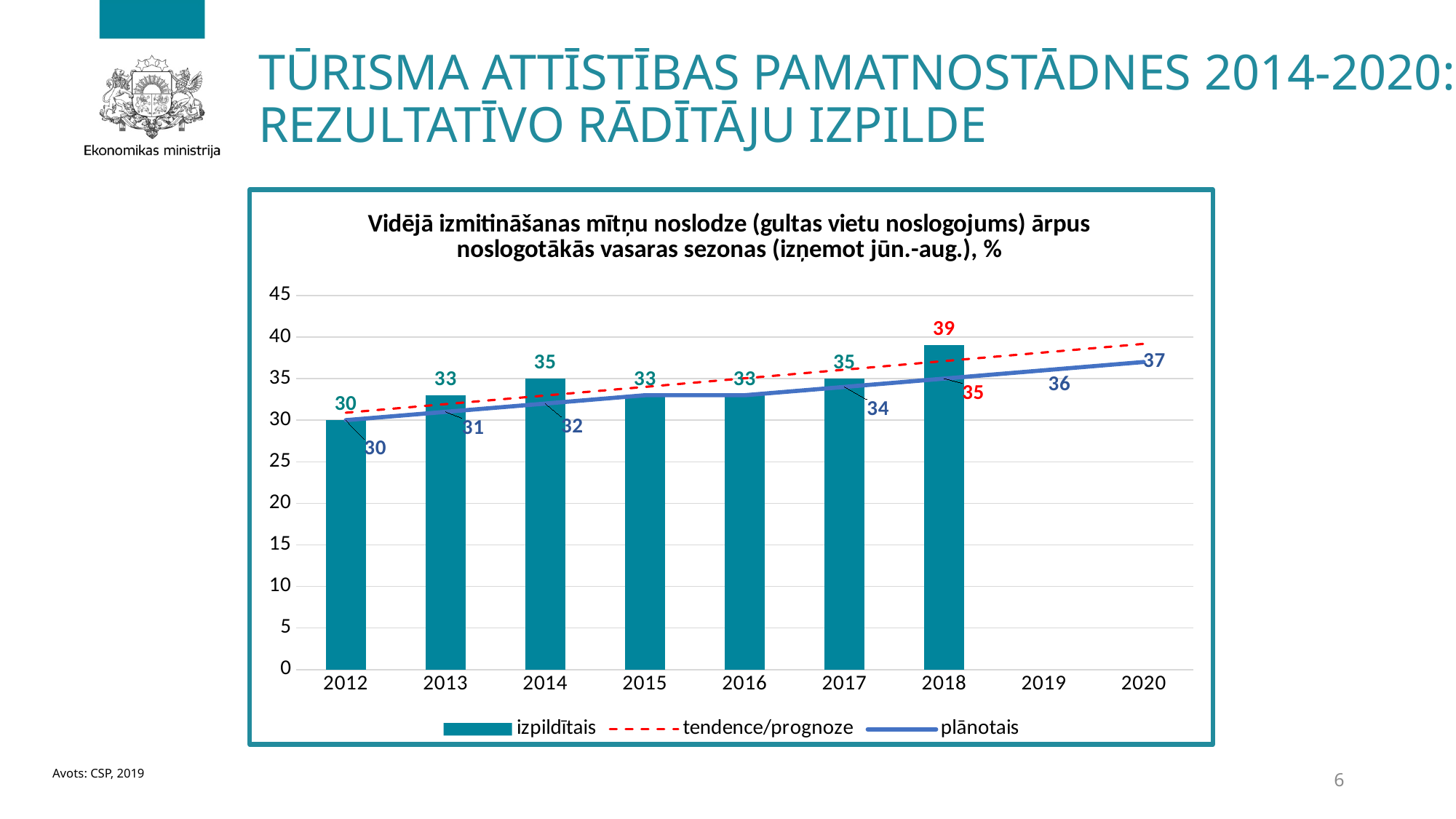
Which series is drawn as a red dashed line? tendence/prognoze How many years have an izpildītais bar? 7 Which year has the highest izpildītais bar? 2018 Which is larger in 2014: the izpildītais value or the plānotais value? izpildītais Does the plānotais line rise or fall from 2012 to 2020? rise What is the plānotais value for 2020? 37 What is the plānotais value for 2013? 31 What is the difference between the izpildītais value for 2018 and the plānotais value for 2018? 4 How many series does the legend list? 3 Which year has the lowest izpildītais bar? 2012 What is the izpildītais value for 2018? 39 What is the izpildītais value for 2014? 35